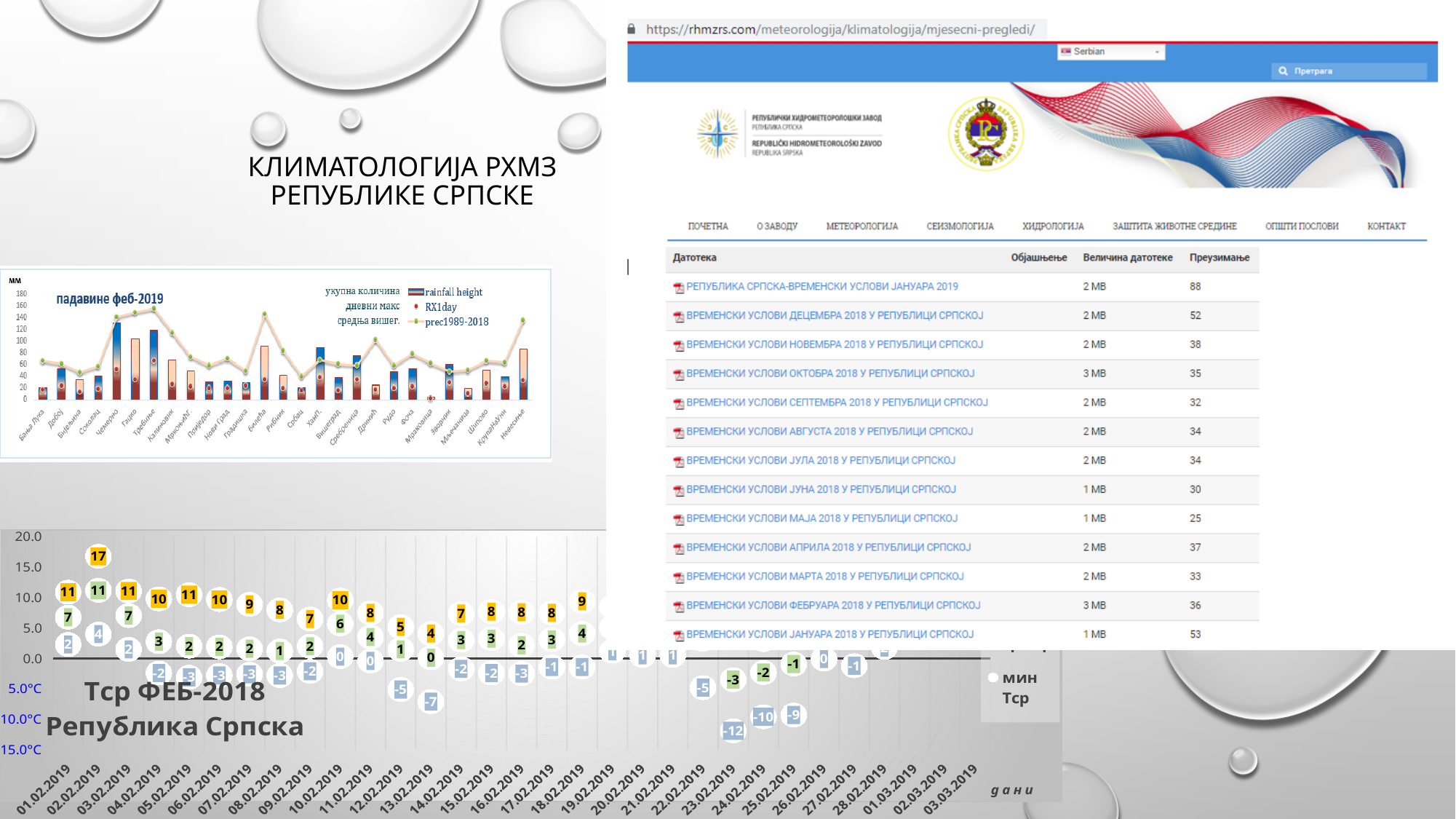
In the bottom chart 'Тср ФЕБ-2018 Република Српска', on which date does the lowest value -12 occur? 23.02.2019 In the bottom chart 'Тср ФЕБ-2018 Република Српска', what is the lowest data label shown? -12 In the top-left chart 'падавине феб-2019', is the rainfall height bar for Чемерно greater or less than 100? greater In the top-left chart 'падавине феб-2019', is the rainfall height bar for Требиње greater or less than 100? greater In the bottom chart 'Тср ФЕБ-2018 Република Српска', on which date does the highest value 17 occur? 02.02.2019 In the top-left chart 'падавине феб-2019', is the rainfall height bar for Бања Лука greater or less than 40? less In the top-left chart 'падавине феб-2019', which has the taller rainfall height bar, Чемерно or Добој? Чемерно What kind of chart is the top-left chart 'падавине феб-2019'? combination bar and line chart In the top-left chart 'падавине феб-2019', what unit is shown on the y axis? мм How many series does the legend of the top-left chart list? 3 In the bottom chart 'Тср ФЕБ-2018 Република Српска', what is the highest data label shown? 17 What is the title of the top-left chart? падавине феб-2019